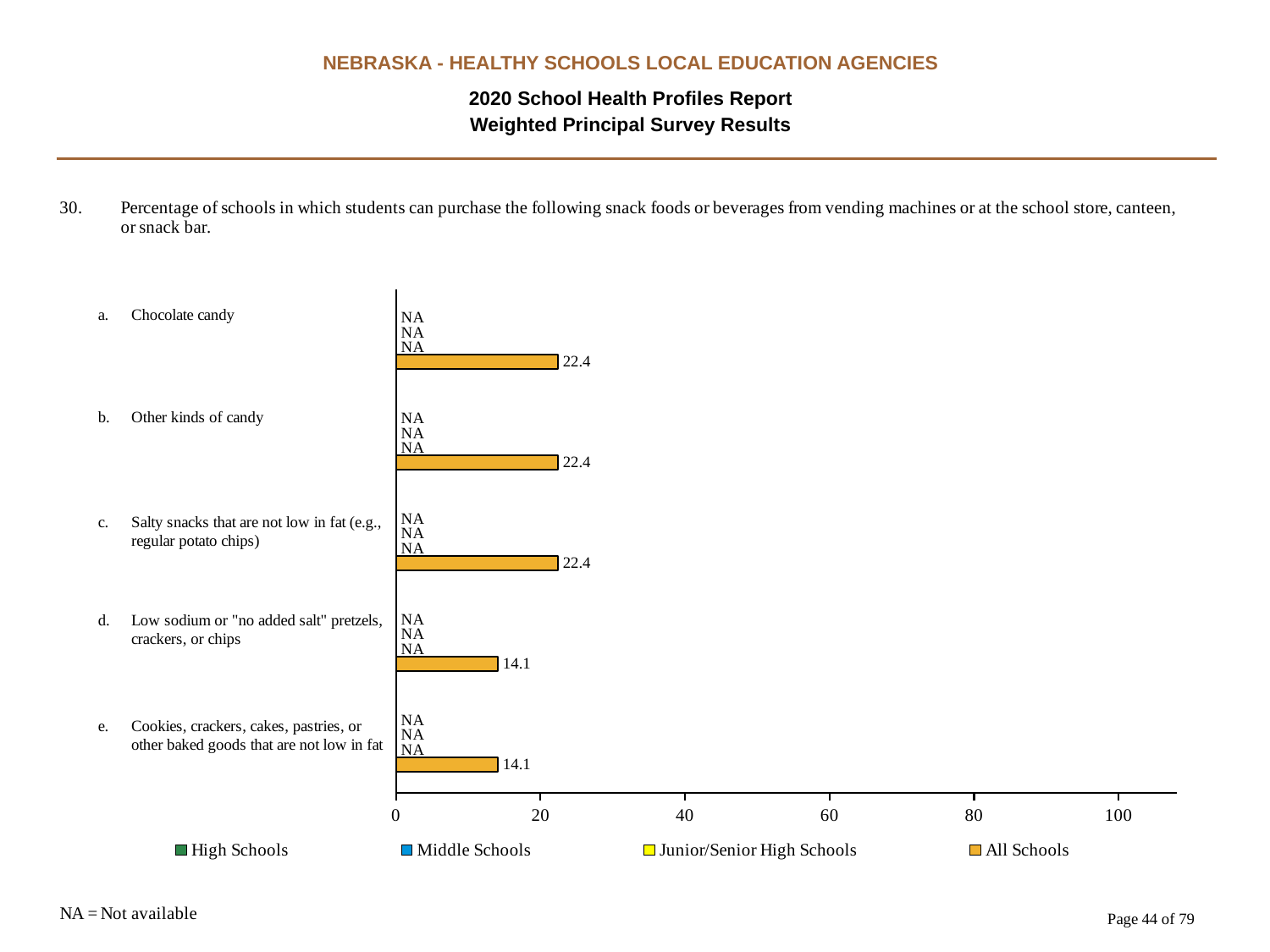
Is the All Schools value for Cookies, crackers, cakes, pastries, or other baked goods that are not low in fat greater or less than 20? less What is the All Schools value for Cookies, crackers, cakes, pastries, or other baked goods that are not low in fat? 14.1 Which is larger for All Schools: Salty snacks that are not low in fat or Cookies, crackers, cakes, pastries, or other baked goods that are not low in fat? Salty snacks that are not low in fat What is the difference between the All Schools values for Chocolate candy and Low sodium or "no added salt" pretzels, crackers, or chips? 8.3 Is the All Schools value for Chocolate candy greater or less than 20? greater How many series does the legend list? 4 What is the All Schools value for Chocolate candy? 22.4 What is the All Schools value for Other kinds of candy? 22.4 What kind of chart is shown on the slide? bar chart How many snack food categories are listed in the chart? 5 What value is shown for High Schools for Chocolate candy? NA What is the All Schools value for Low sodium or "no added salt" pretzels, crackers, or chips? 14.1